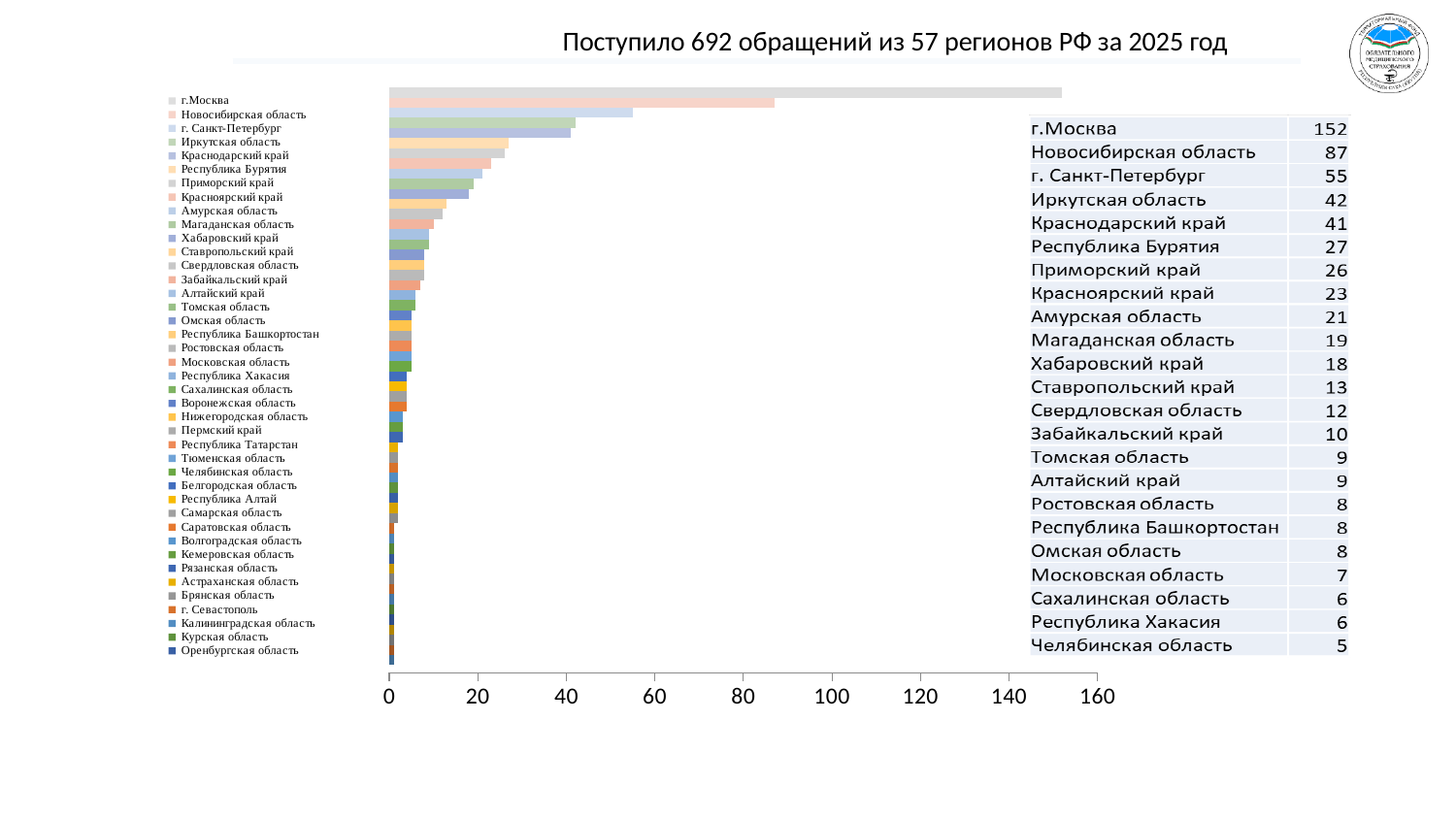
How many обращений came from Республика Бурятия? 27 What type of chart is shown on the slide? bar chart Is the value for Новосибирская область greater or less than 100? less Is the value for г. Санкт-Петербург greater or less than 40? greater What is the maximum value shown on the horizontal axis? 160 What is the difference between the values for Амурская область and Магаданская область? 2 What is the title of the chart on the slide? Поступило 692 обращений из 57 регионов РФ за 2025 год What is the difference between the values for г.Москва and Новосибирская область? 65 Which is larger, the value for Иркутская область or Краснодарский край? Иркутская область Which region has the highest number of обращений? г.Москва How many обращений came from г.Москва? 152 How many обращений came from Новосибирская область? 87